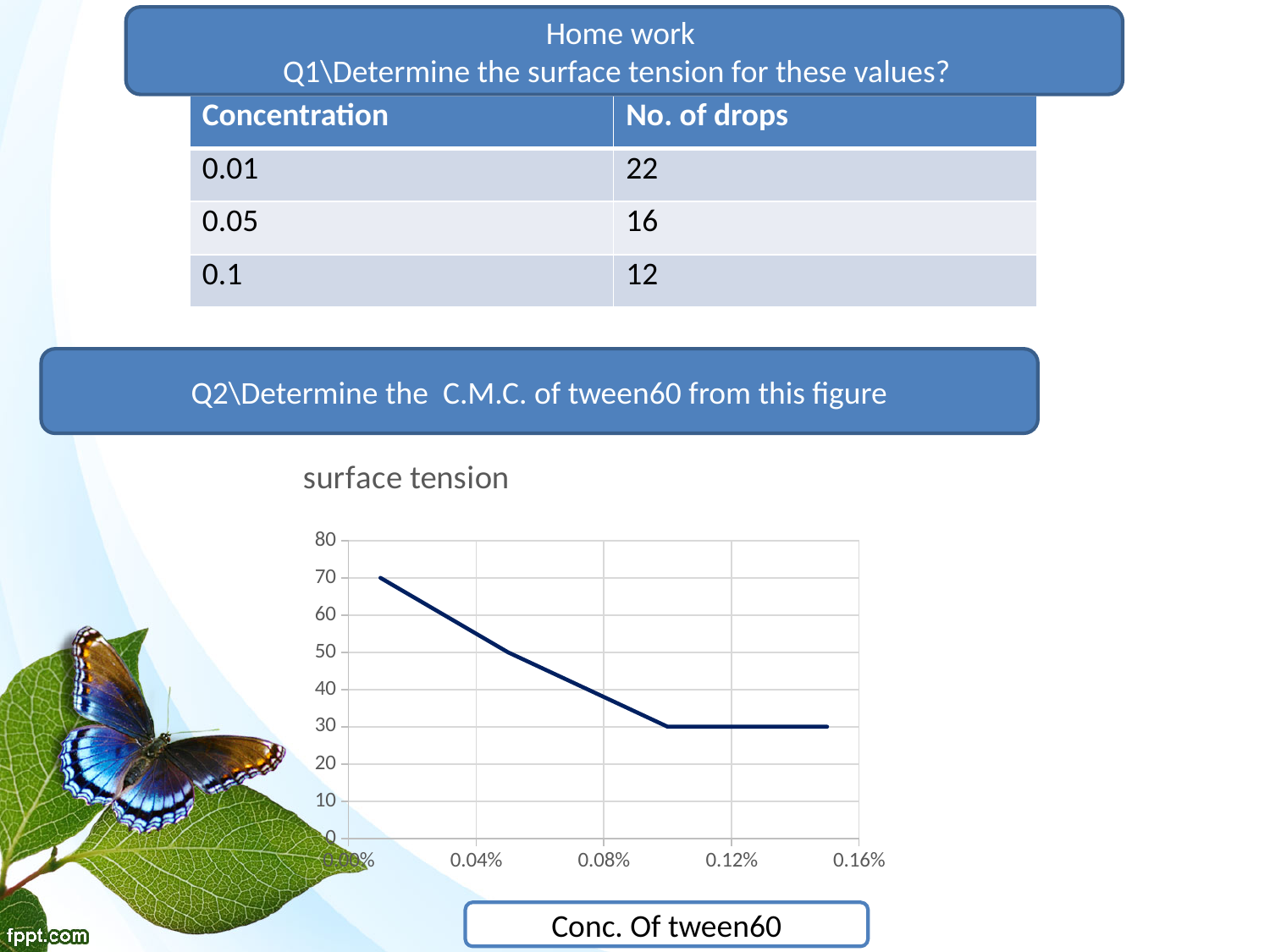
How many lines are plotted on the surface tension chart? 1 Which concentration has the higher surface tension, 0.04% or 0.12%? 0.04% Is the surface tension at 0.04% concentration greater or less than 40? greater Is the surface tension at 0.04% concentration greater or less than 60? less What is the title of the chart on the slide? surface tension What is the highest value shown on the y axis of the chart? 80 Is the surface tension at 0.12% concentration greater or less than 40? less What label is given for the x axis of the chart? Conc. Of tween60 Between 0.12% and 0.16% concentration, does the line rise, fall, or stay flat? stay flat Does the surface tension rise or fall as the concentration increases from 0.00% to 0.08%? fall What kind of chart is shown under Q2 on the slide? line chart